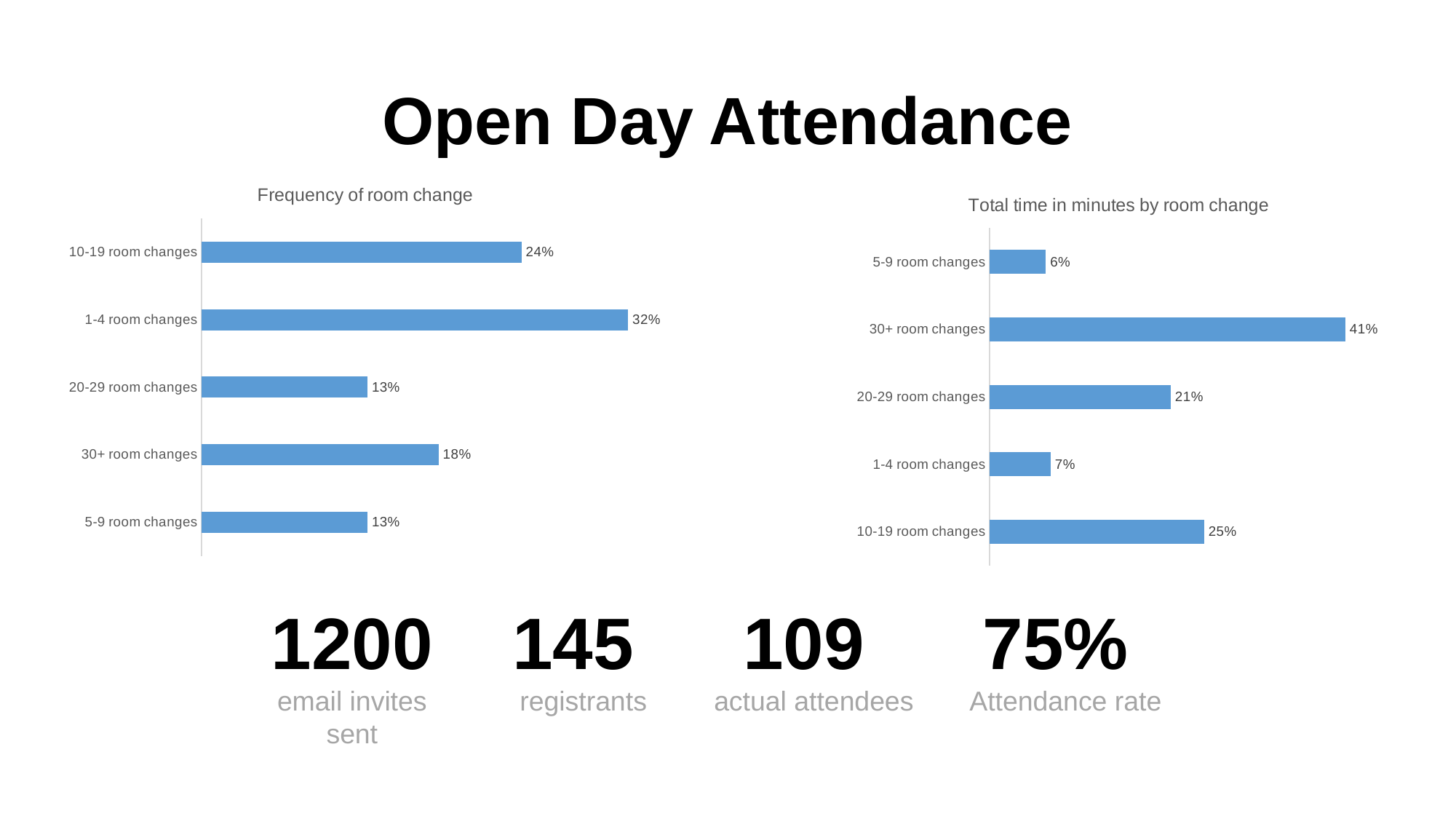
In the 'Frequency of room change' chart, what is the value for 30+ room changes? 18% In the 'Total time in minutes by room change' chart, what is the value for 30+ room changes? 41% In the 'Total time in minutes by room change' chart, which is larger: 20-29 room changes or 10-19 room changes? 10-19 room changes In the 'Total time in minutes by room change' chart, which category has the lowest value? 5-9 room changes In the 'Frequency of room change' chart, what is the difference between 1-4 room changes and 10-19 room changes? 8% In the 'Frequency of room change' chart, what is the value for 1-4 room changes? 32% In the 'Total time in minutes by room change' chart, what is the value for 1-4 room changes? 7% In the 'Total time in minutes by room change' chart, what is the difference between 30+ room changes and 20-29 room changes? 20% What is the title of the chart on the left side of the slide? Frequency of room change In the 'Frequency of room change' chart, how many categories are shown? 5 What type of chart is the 'Total time in minutes by room change' chart? Bar chart In the 'Frequency of room change' chart, which category has the highest value? 1-4 room changes